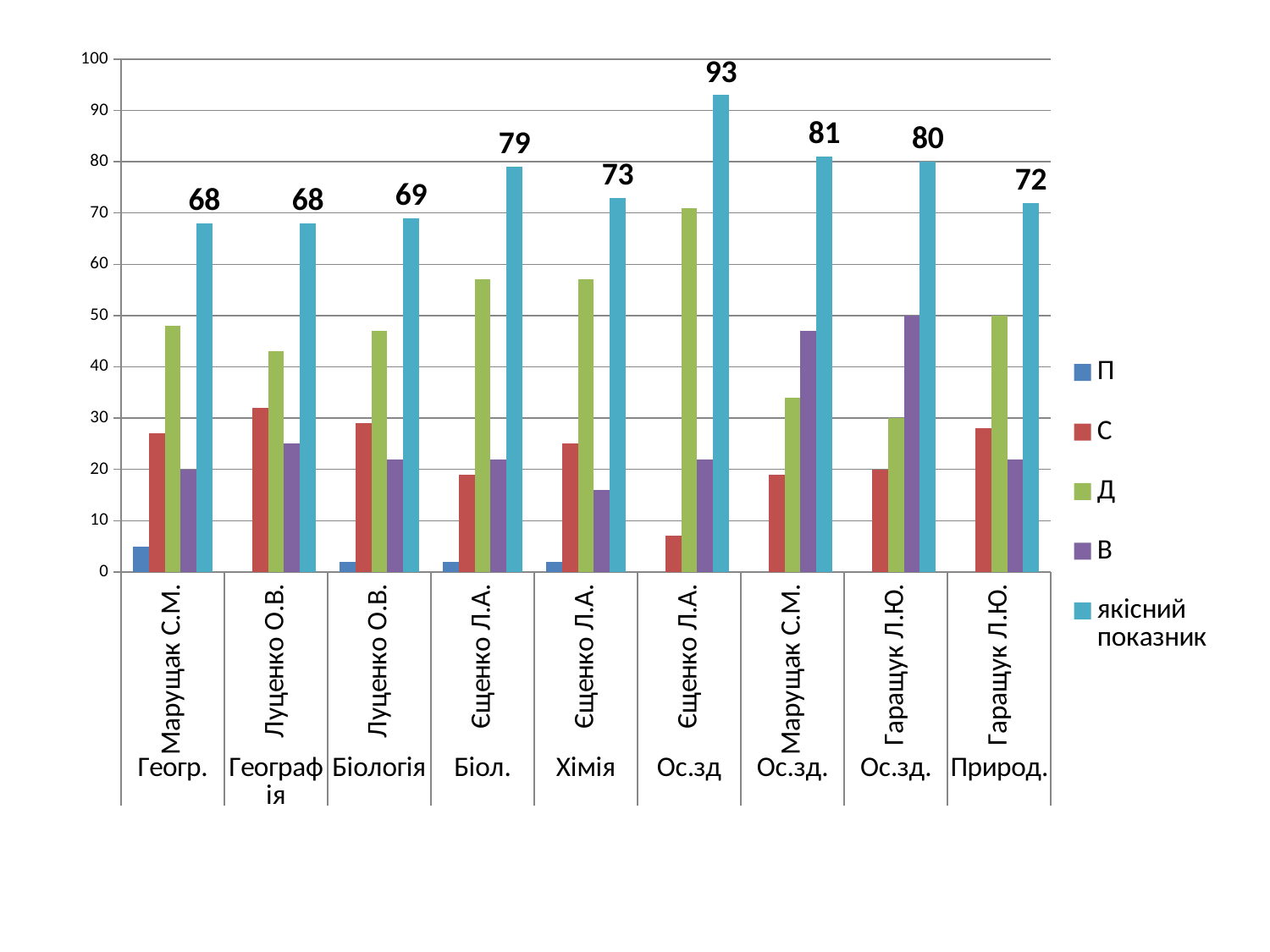
What is the якісний показник value for Гаращук Л.Ю. in Природ.? 72 What kind of chart is shown on the slide? bar chart What is the lowest якісний показник value shown on the chart? 68 Which is larger: the якісний показник for Єщенко Л.А. Біол. or for Луценко О.В. Біологія? Єщенко Л.А. Біол. What is the якісний показник value for Єщенко Л.А. in Хімія? 73 Does the якісний показник rise or fall from Єщенко Л.А. Ос.зд to Гаращук Л.Ю. Природ.? fall How many series does the legend list? 5 Is the В value for Гаращук Л.Ю. Ос.зд. greater or less than 40? greater How many categories are shown on the x axis? 9 Which category has the highest якісний показник value? Єщенко Л.А. Ос.зд Is the Д value for Єщенко Л.А. Ос.зд greater or less than 60? greater What is the difference between the якісний показник for Єщенко Л.А. Ос.зд and for Марущак С.М. Геогр.? 25